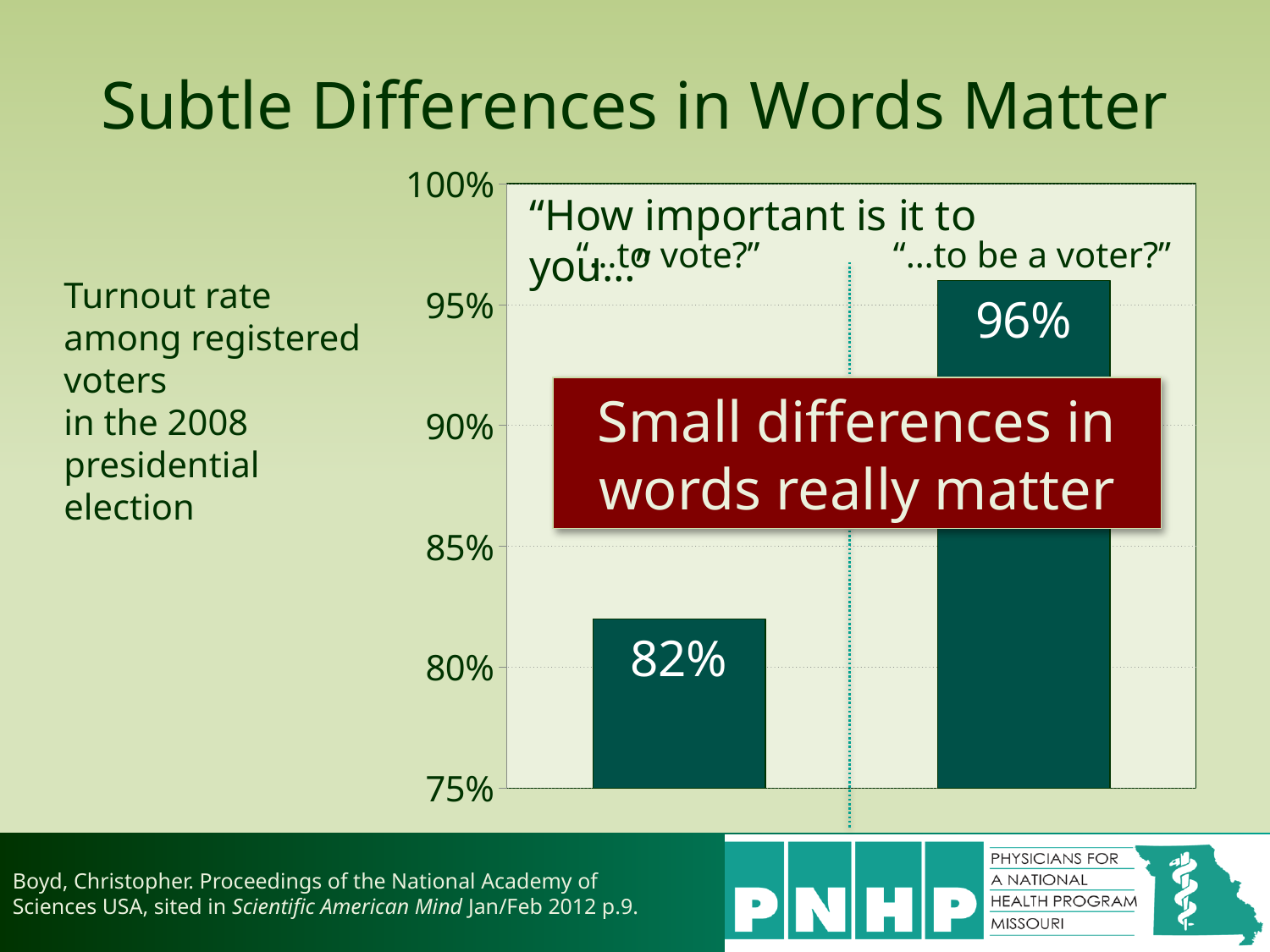
What is the difference in turnout rate between the "...to be a voter?" and "...to vote?" wordings? 14% What is the turnout rate for the "...to be a voter?" wording? 96% How many bars are plotted in the chart? 2 Which wording has the lower turnout rate? "...to vote?" What is the turnout rate for the "...to vote?" wording? 82% Is the turnout rate for "...to vote?" larger or smaller than the rate for "...to be a voter?"? smaller What text appears in the red box overlaid on the chart? Small differences in words really matter Is the value for "...to vote?" greater or less than 85%? less Which wording has the higher turnout rate? "...to be a voter?" What is the lowest value shown on the vertical axis of the chart? 75% What kind of chart is shown on the slide? bar chart Is the value for "...to be a voter?" greater or less than 90%? greater